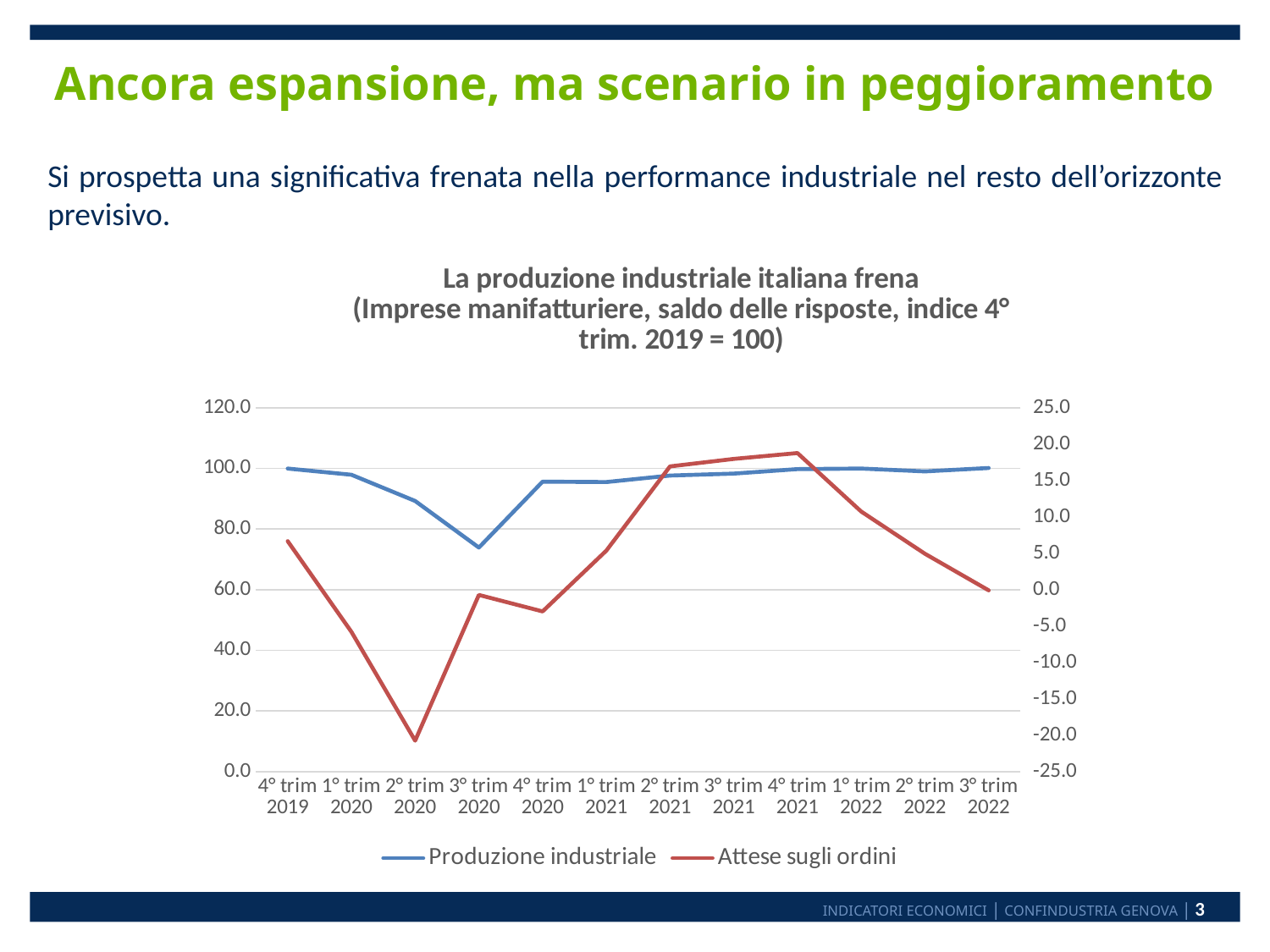
In which quarter does Attese sugli ordini reach its lowest point? 2° trim 2020 Does Attese sugli ordini rise or fall from 4° trim 2021 to 3° trim 2022? fall Is the value for Attese sugli ordini in 2° trim 2020 greater or less than -15.0? less What kind of chart is shown on the slide? line chart Which is larger for Produzione industriale: the value in 2° trim 2020 or in 3° trim 2020? 2° trim 2020 In which quarter does Produzione industriale reach its lowest point? 3° trim 2020 Is the value for Attese sugli ordini in 4° trim 2021 greater or less than 15.0? greater How many quarters are shown along the x axis? 12 In which quarter does Attese sugli ordini reach its highest point? 4° trim 2021 How many series does the legend list? 2 Is the value for Produzione industriale in 3° trim 2020 greater or less than 80.0? less